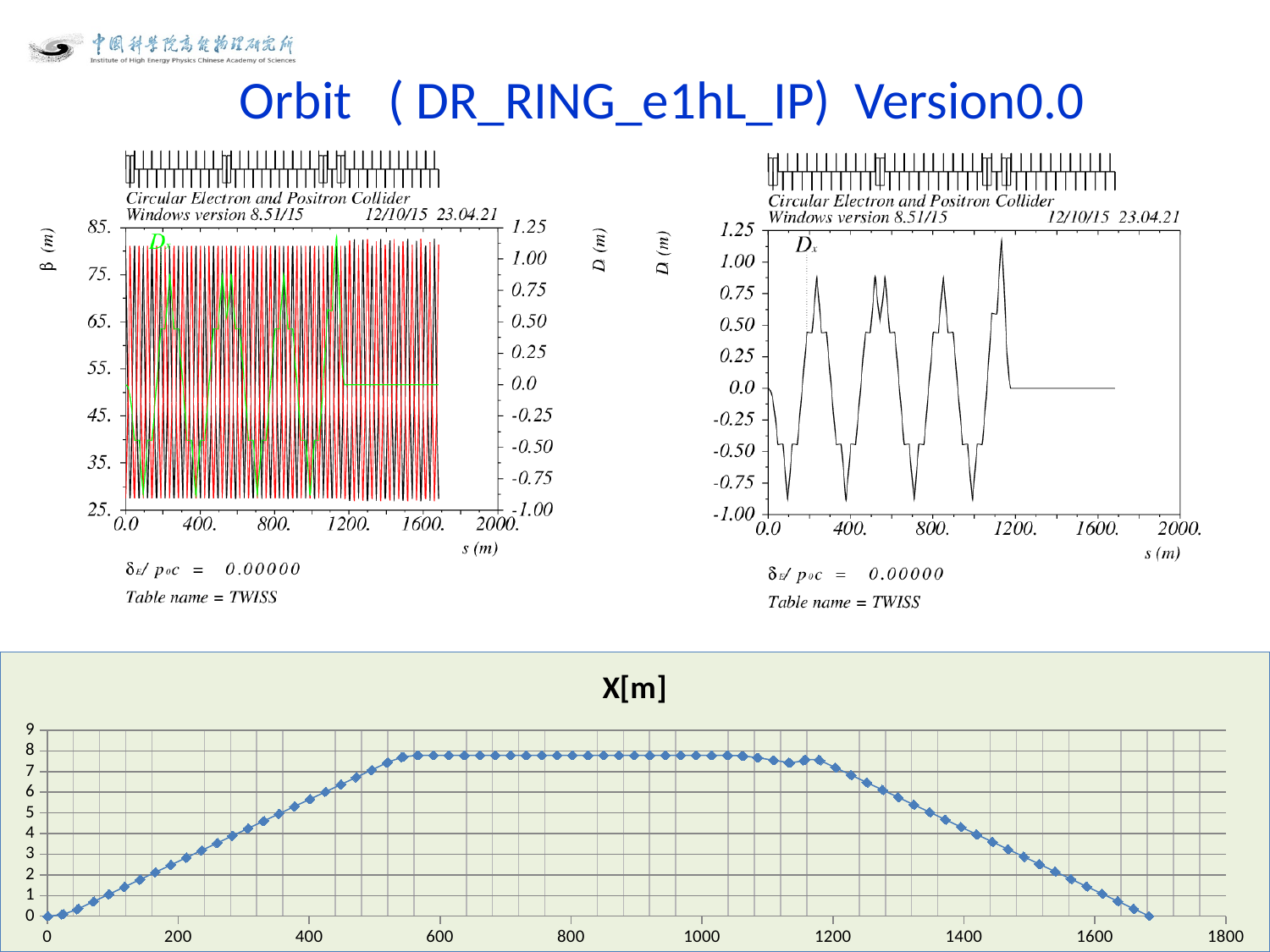
In the bottom chart titled X[m], what is the highest value shown on the vertical axis? 9 In the bottom chart titled X[m], is the value at s = 600 greater or less than 7? greater In the bottom chart titled X[m], is the value at s = 100 greater or less than 2? less What kind of chart is the bottom chart titled X[m]? line chart In the bottom chart titled X[m], how do the values change between s = 1200 and s = 1700? they fall In the top right chart, is the lowest value of Dx greater or less than -0.75? less In the top right chart, what is the value of Dx on the flat section at s = 1600? 0.0 In the bottom chart titled X[m], how do the values change between s = 0 and s = 500? they rise What is the table name printed below the top left chart? TWISS